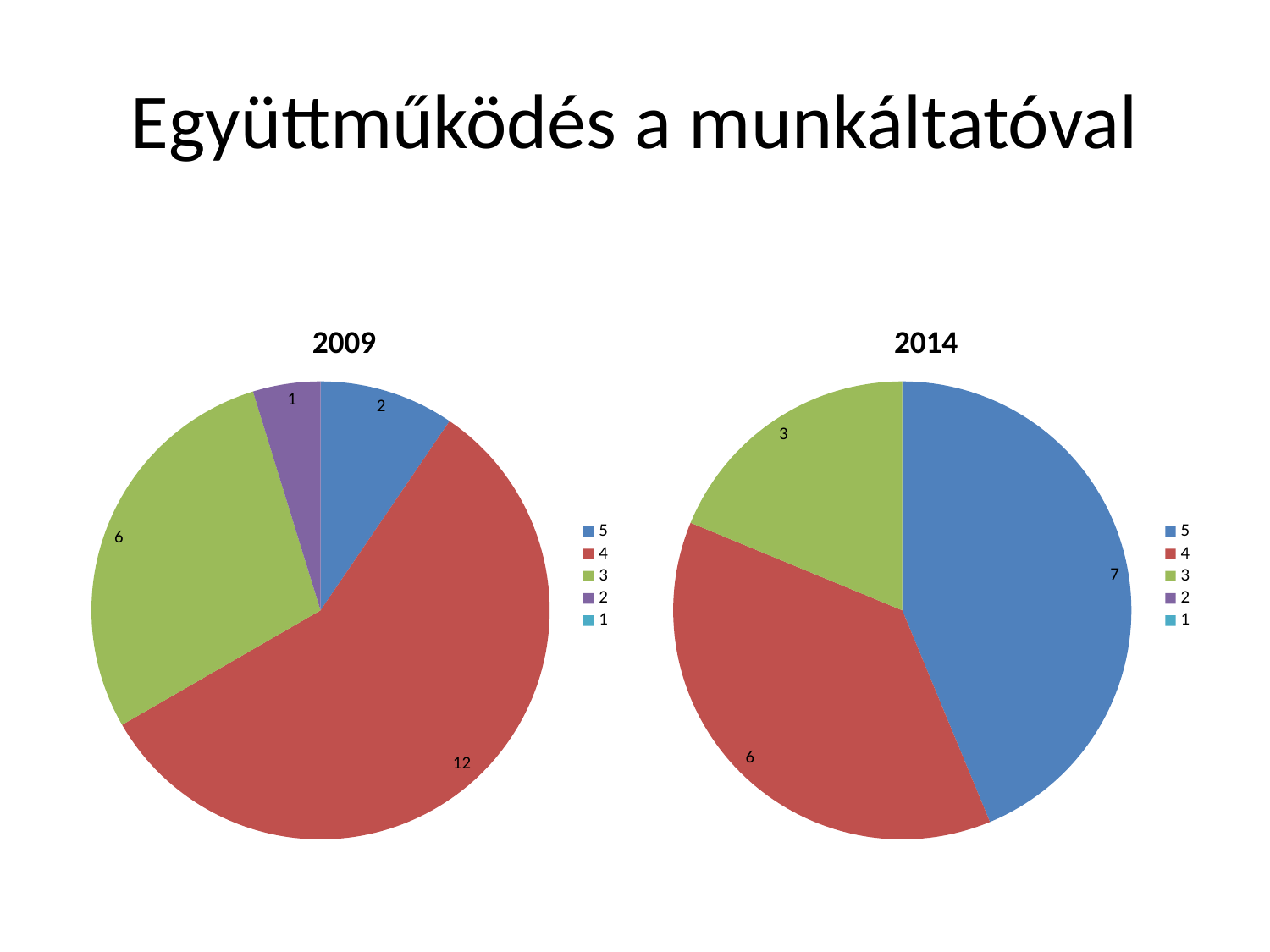
In the 2014 pie chart, which category has the smallest slice? 3 What kind of chart is the 2014 chart? pie chart In the 2009 pie chart, what is the value for category 3? 6 In the 2014 pie chart, what is the value for category 5? 7 How many entries does the legend of the 2014 chart list? 5 In the 2014 pie chart, what is the value for category 3? 3 In the 2009 pie chart, which category has the largest slice? 4 How many slices are shown in the 2009 pie chart? 4 In the 2014 pie chart, which is larger, the value for category 5 or category 4? 5 In the 2014 pie chart, what share of the total does category 4 represent? 37.5% In the 2009 pie chart, what is the value for category 4? 12 In the 2009 pie chart, what is the difference between the values for category 4 and category 3? 6